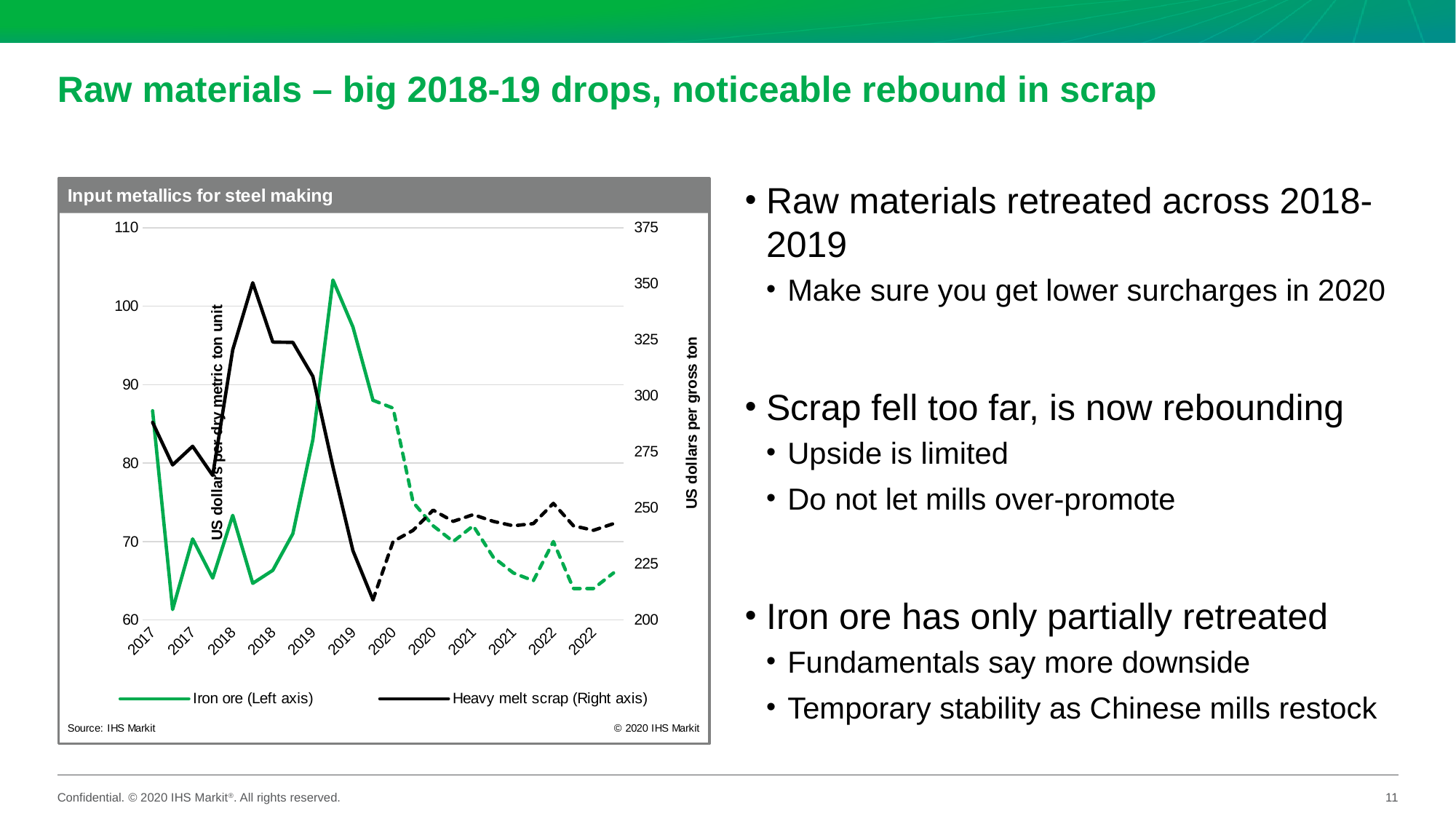
How many series does the chart legend list? 2 Is the peak value of the Iron ore line in 2019 greater or less than 100 on the left axis? greater Is the lowest value of the Iron ore line in 2017 greater or less than 70 on the left axis? less How many year labels are shown along the x axis of the chart? 12 What kind of chart is shown on the slide? Line chart Is the peak value of the Heavy melt scrap line in 2018 greater or less than 325 on the right axis? greater Does the Heavy melt scrap line rise or fall from its 2018 peak to 2020? Fall Does the Iron ore line rise or fall from its 2019 peak to 2020? Fall What is the title of the chart? Input metallics for steel making Which series is plotted against the right axis according to the legend? Heavy melt scrap (Right axis)